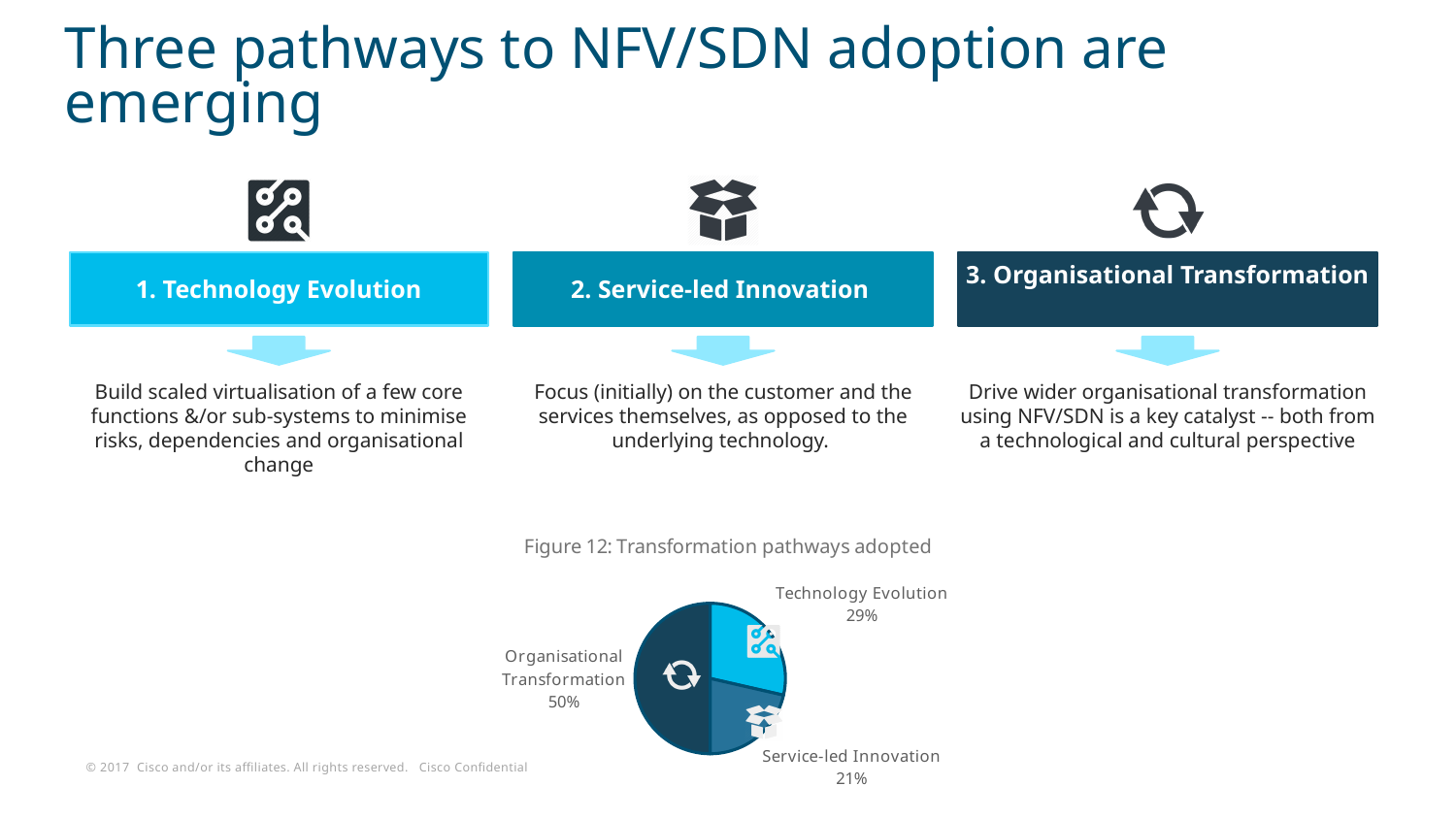
Which pathway has the smallest slice of the pie chart? Service-led Innovation What share of the pie chart is Organisational Transformation? 50% What kind of chart is shown on the slide? Pie chart What is the title of the chart on the slide? Figure 12: Transformation pathways adopted Which is larger in the pie chart, Technology Evolution or Service-led Innovation? Technology Evolution How many slices does the pie chart have? 3 What is the combined share of Technology Evolution and Service-led Innovation in the pie chart? 50% What share of the pie chart is Technology Evolution? 29% What is the difference in percentage points between Organisational Transformation and Technology Evolution? 21 What is the difference in percentage points between Technology Evolution and Service-led Innovation? 8 Which pathway has the largest slice of the pie chart? Organisational Transformation What share of the pie chart is Service-led Innovation? 21%